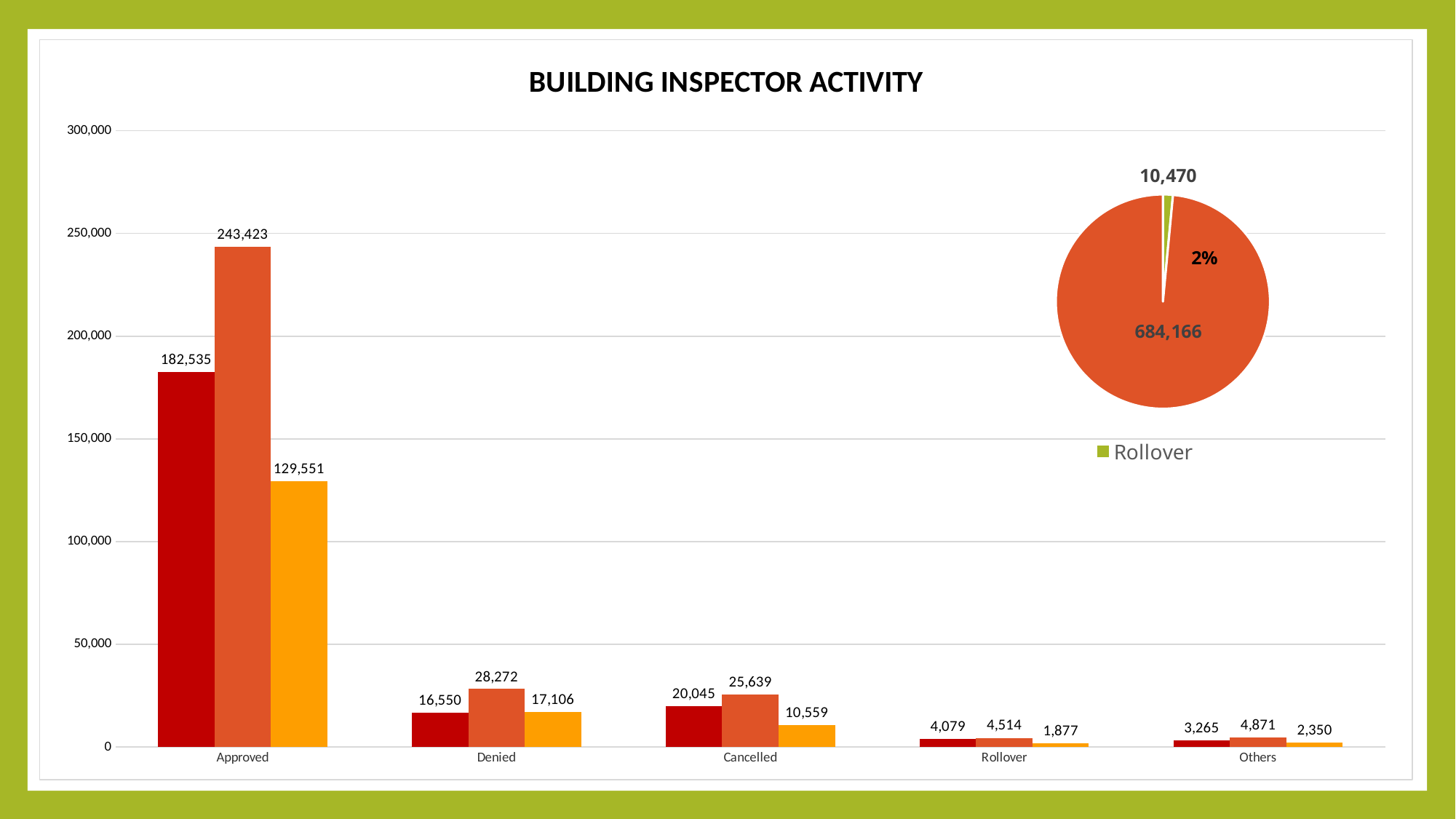
What kind of chart is the large chart on the left of the slide? Bar chart In the bar chart, what is the value of the first (dark red) bar for Others? 3,265 In the pie chart, what share of the pie does the Rollover slice represent? 2% In the bar chart, what is the value of the third (yellow-orange) bar for Cancelled? 10,559 In the bar chart, which category has the highest values? Approved In the bar chart, for Denied, which is larger: the first bar (16,550) or the third bar (17,106)? The third bar, 17,106 In the pie chart, what value is shown for the Rollover slice? 10,470 In the bar chart, what is the value of the middle bar for Approved? 243,423 In the bar chart, is the value of the first bar for Approved greater or less than 200,000? less In the bar chart, what is the difference between the middle bar and the first bar for Approved? 60,888 In the bar chart, which of the three Rollover bars has the lowest value? The third bar, 1,877 How many categories are shown on the x axis of the bar chart? 5